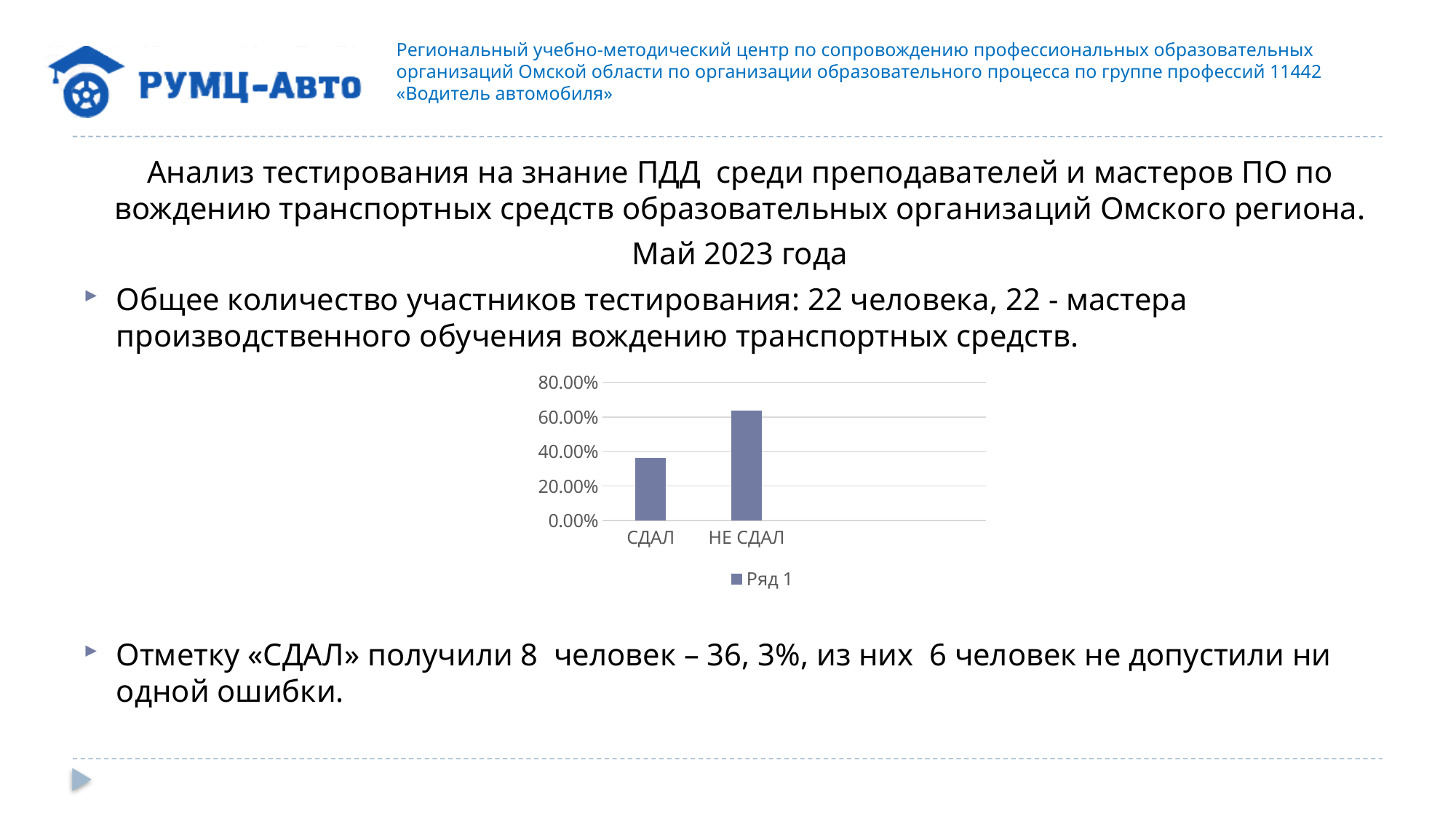
Which bar is taller, СДАЛ or НЕ СДАЛ? НЕ СДАЛ Is the value for НЕ СДАЛ greater or less than 80.00%? less Which category has the highest bar in the chart? НЕ СДАЛ What kind of chart is shown on the slide? bar chart Is the value for СДАЛ greater or less than 40.00%? less What is the name of the series shown in the chart legend? Ряд 1 What is the highest tick label on the chart's vertical axis? 80.00% Which category has the lowest bar in the chart? СДАЛ Is the value for НЕ СДАЛ greater or less than 60.00%? greater How many series does the chart legend list? 1 How many categories are shown on the x axis of the chart? 2